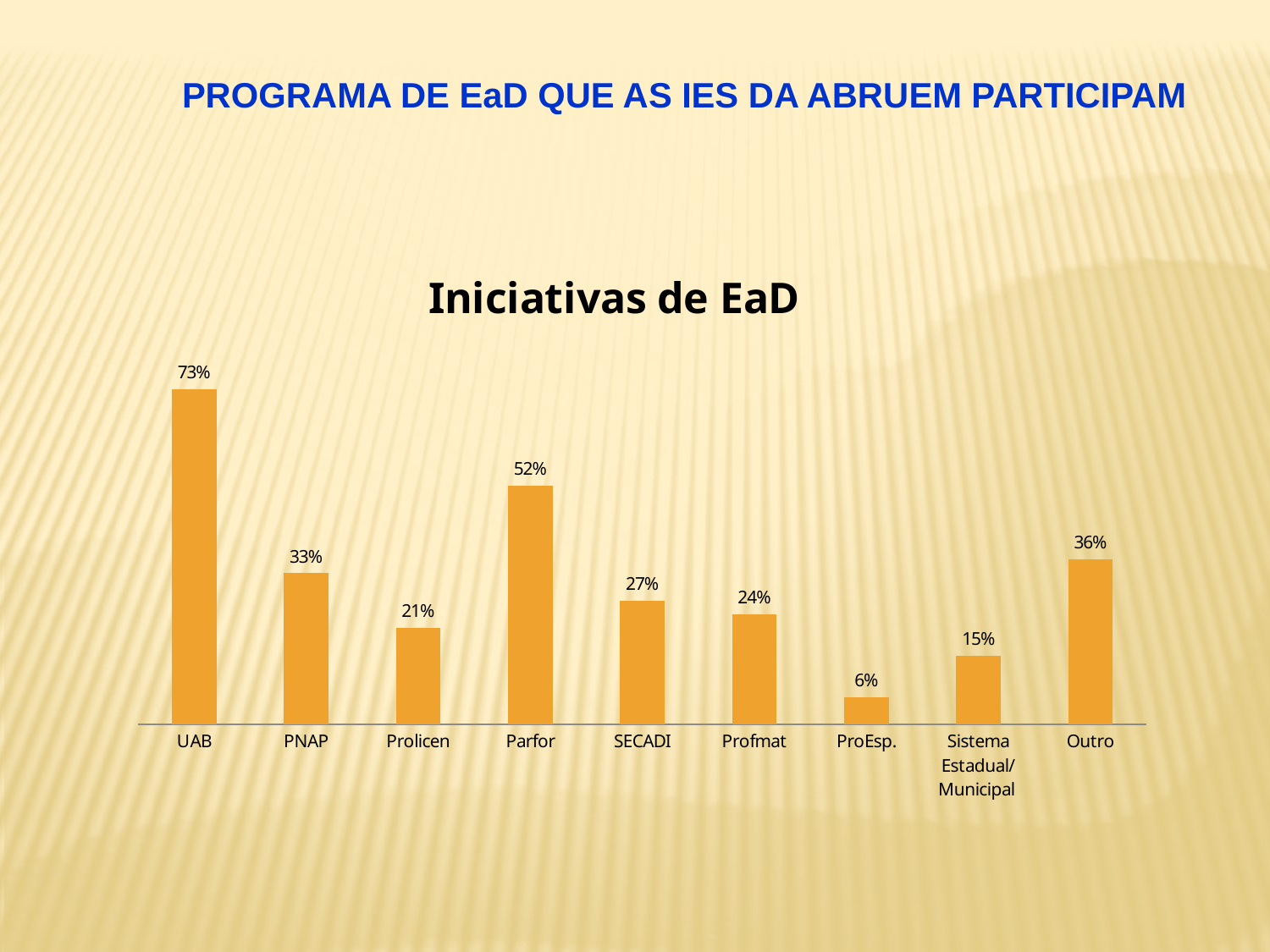
What is the value for Parfor? 52% What is the title of the chart? Iniciativas de EaD Which category has the highest value? UAB What kind of chart is this? Bar chart Which is larger, the value for SECADI or the value for Profmat? SECADI What is the difference between the values for UAB and Parfor? 21% What is the value for Outro? 36% What is the value for UAB? 73% What is the value for Sistema Estadual/Municipal? 15% Which category has the lowest value? ProEsp. What is the difference between the values for PNAP and Prolicen? 12% How many categories are shown on the x axis? 9